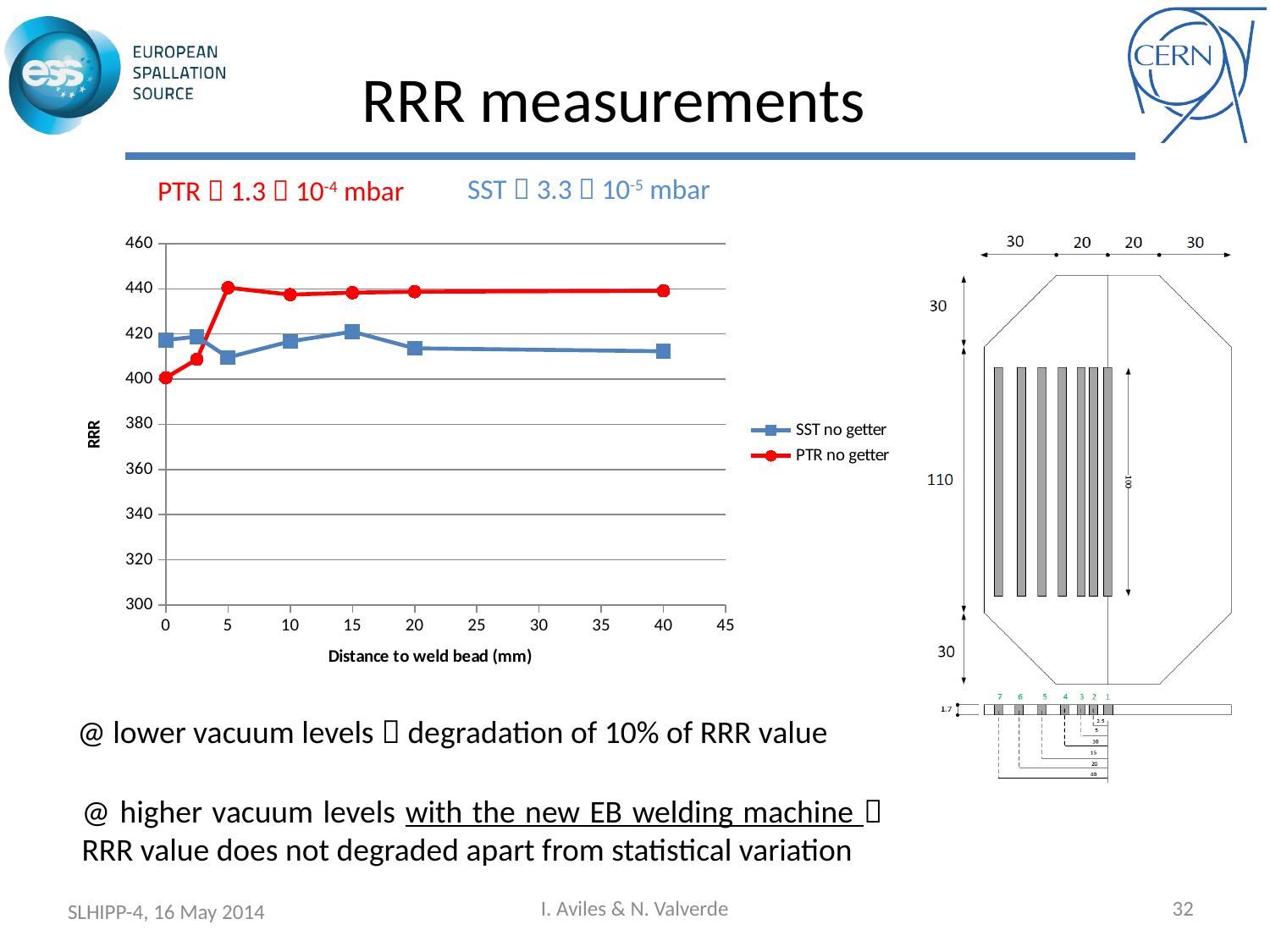
What kind of chart is shown on the slide? line chart Is the RRR value for PTR no getter at 0 mm greater or less than 420? less Does the RRR value for PTR no getter rise or fall between 0 mm and 5 mm? rise Is the RRR value for SST no getter at 40 mm greater or less than 420? less What are the two series named in the chart legend? SST no getter and PTR no getter How many data points are plotted for the PTR no getter series? 7 At 0 mm distance to weld bead, which series has the higher RRR value? SST no getter Is the RRR value for SST no getter at 15 mm greater or less than 400? greater What is the title of the x axis of the chart? Distance to weld bead (mm) At 40 mm distance to weld bead, which series has the higher RRR value? PTR no getter How many series does the chart legend list? 2